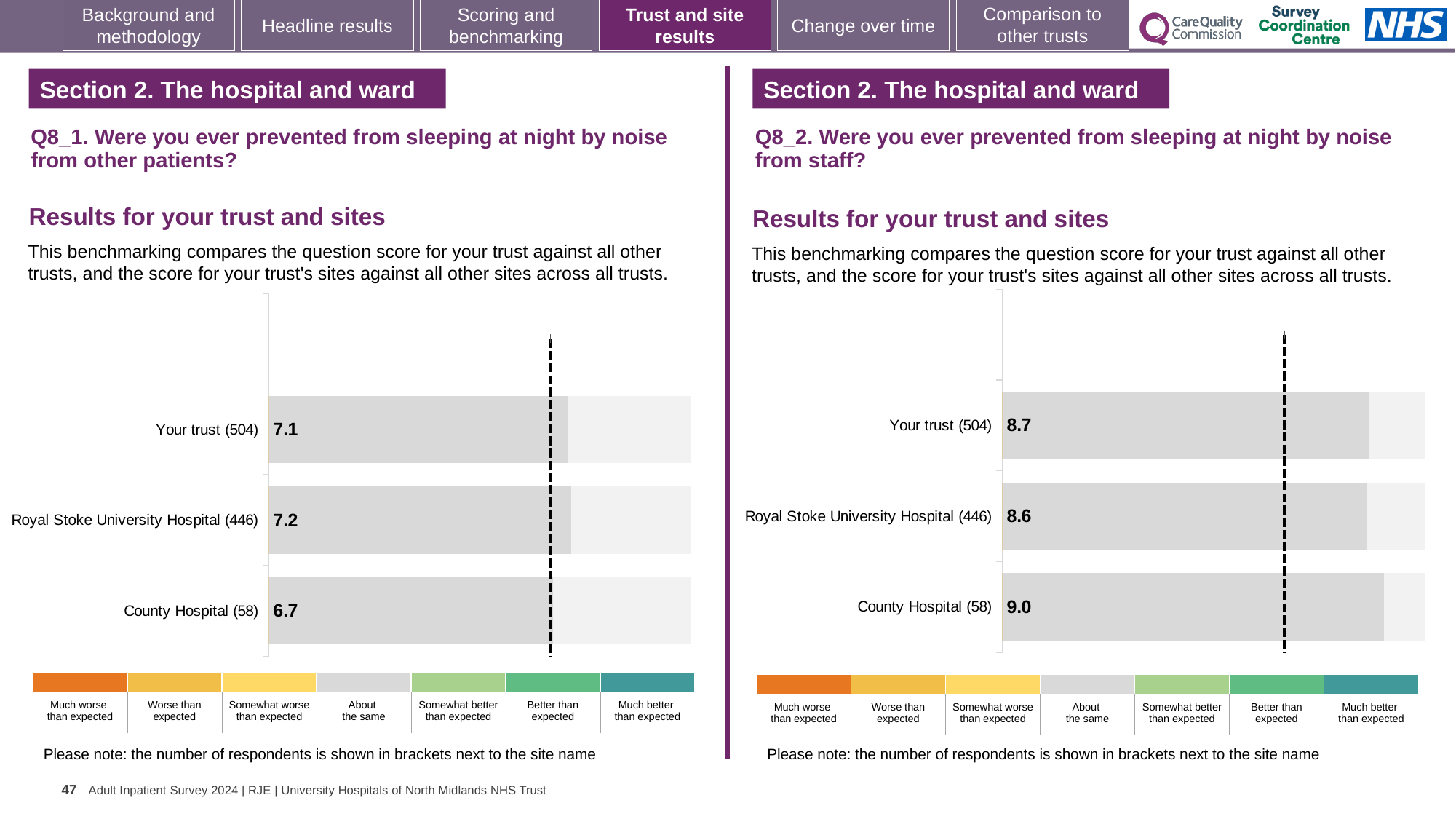
On the left chart (Q8_1, noise from other patients), what is the difference between the scores for Royal Stoke University Hospital (446) and County Hospital (58)? 0.5 On the right chart (Q8_2, noise from staff), which site or trust has the lowest score? Royal Stoke University Hospital (446) On the left chart (Q8_1, noise from other patients), what is the score for Your trust (504)? 7.1 On the right chart (Q8_2, noise from staff), what is the score for County Hospital (58)? 9.0 What type of chart is used on the right side of the slide (Q8_2, noise from staff)? Bar chart How many respondents are shown in brackets for Your trust on the left chart (Q8_1)? 504 On the left chart (Q8_1, noise from other patients), which site or trust has the highest score? Royal Stoke University Hospital (446) On the right chart (Q8_2, noise from staff), what is the difference between the scores for County Hospital (58) and Your trust (504)? 0.3 On the left chart (Q8_1, noise from other patients), what is the score for County Hospital (58)? 6.7 On the right chart (Q8_2, noise from staff), what is the score for Royal Stoke University Hospital (446)? 8.6 On the right chart (Q8_2, noise from staff), which has the higher score: Your trust (504) or County Hospital (58)? County Hospital (58) How many bars are plotted on the left chart (Q8_1, noise from other patients)? 3